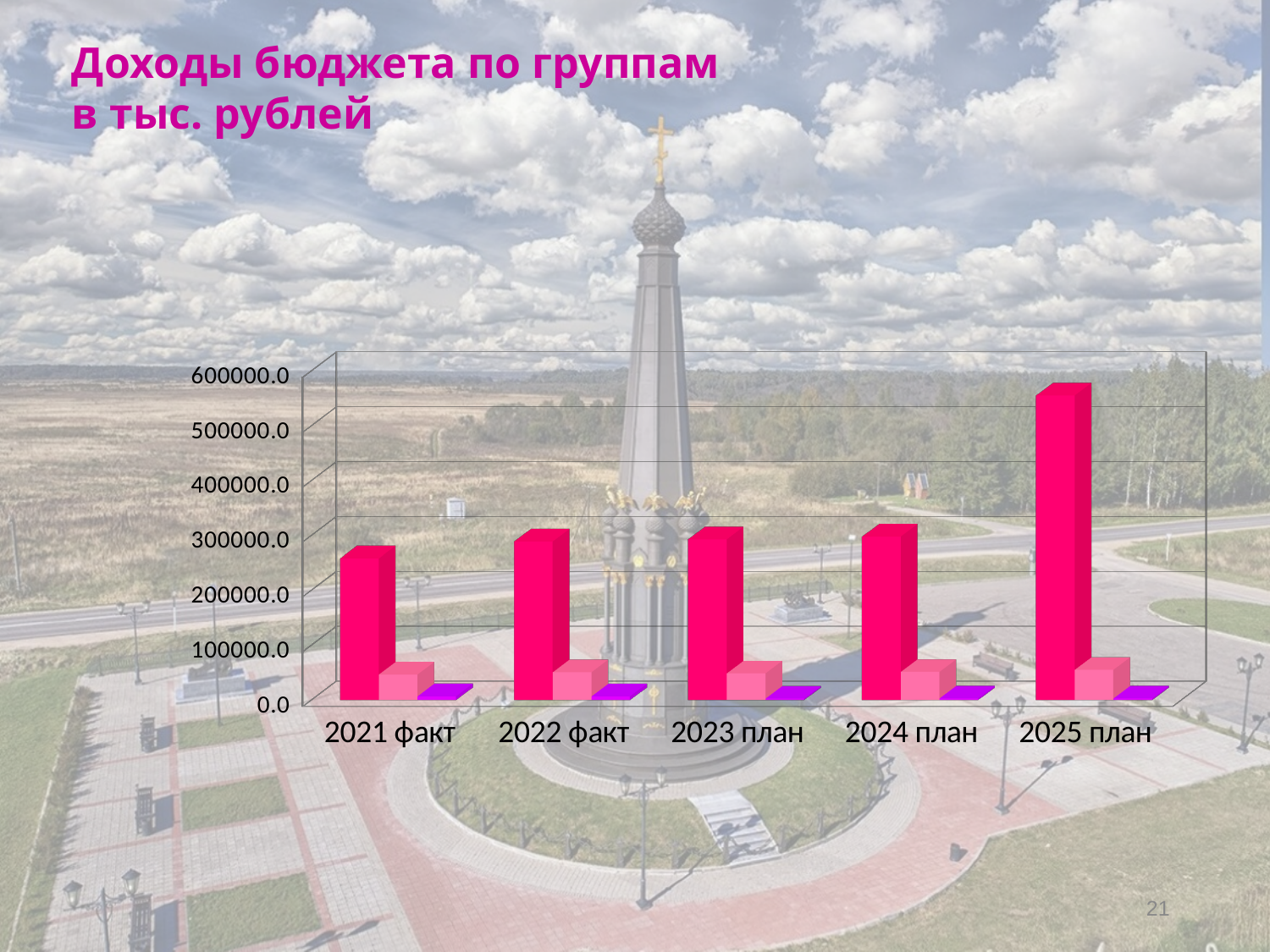
Is the tallest bar for 2024 план greater or less than 400000.0? less Which is larger, the tallest bar for 2021 факт or the tallest bar for 2025 план? 2025 план How many categories are shown on the x axis of the chart? 5 Is the tallest bar for 2021 факт greater or less than 200000.0? greater Which category has the shortest tallest-series bar in the chart? 2021 факт What kind of chart is shown on the slide? bar chart Which category has the tallest bar in the chart? 2025 план What is the title of the slide containing the chart? Доходы бюджета по группам в тыс. рублей How many bars are plotted for each category in the chart? 3 Is the tallest bar for 2025 план greater or less than 500000.0? greater Do the tallest bars generally rise or fall from 2021 факт to 2025 план? rise